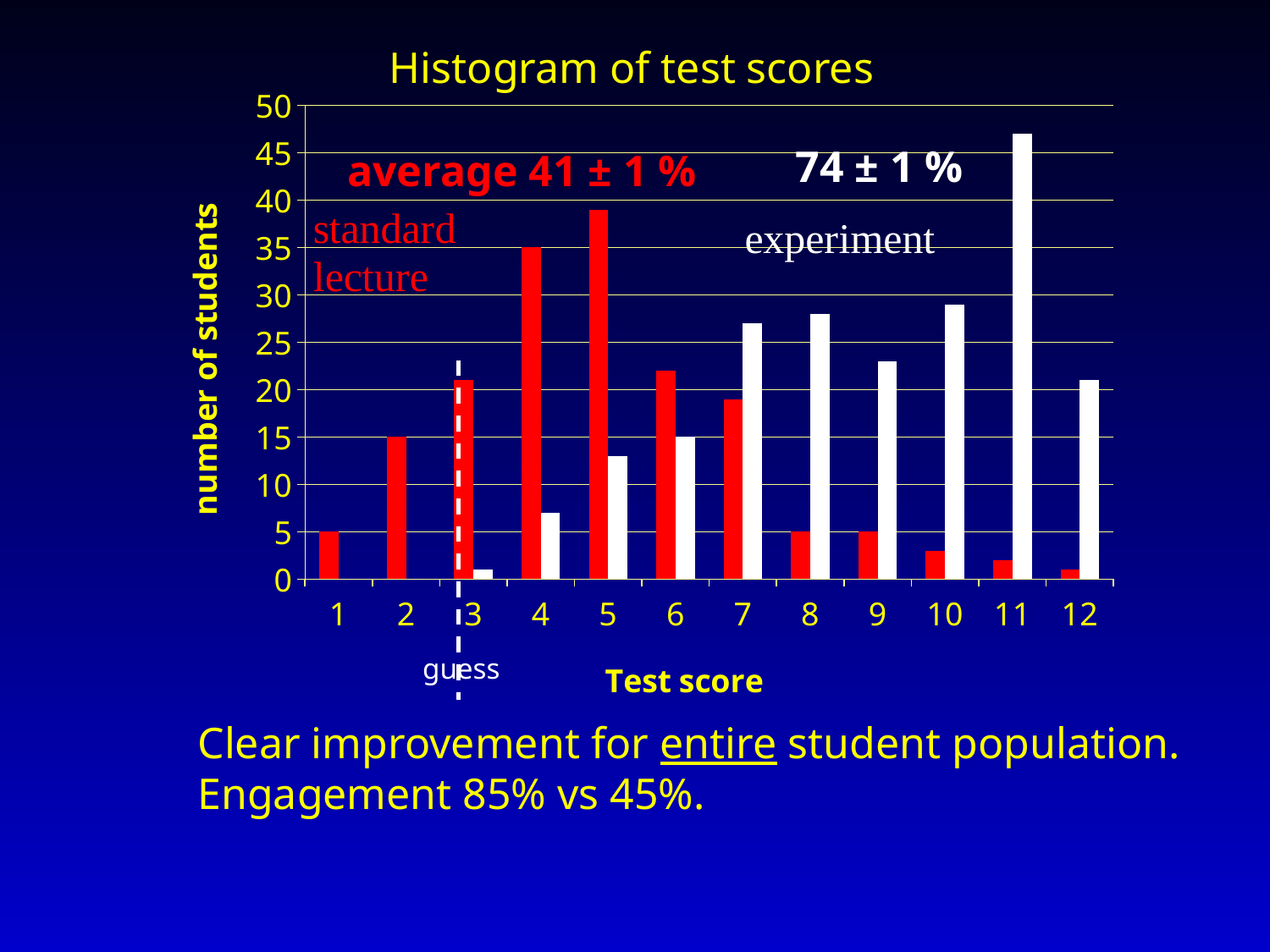
What average test score is stated on the slide for the experiment group? 74 ± 1 % What is the title of the chart? Histogram of test scores How many series are plotted in the chart? 2 What is the number of students for the experiment series at test score 6? 15 What is the number of students for the standard lecture series at test score 1? 5 At which test score is the experiment series highest? 11 At which test score is the standard lecture series highest? 5 How many test score categories are shown on the x axis? 12 What is the number of students for the standard lecture series at test score 2? 15 Is the value for the experiment series at test score 11 greater or less than 45? greater At test score 7, which series has the larger number of students, standard lecture or experiment? experiment What kind of chart is shown on the slide? bar chart